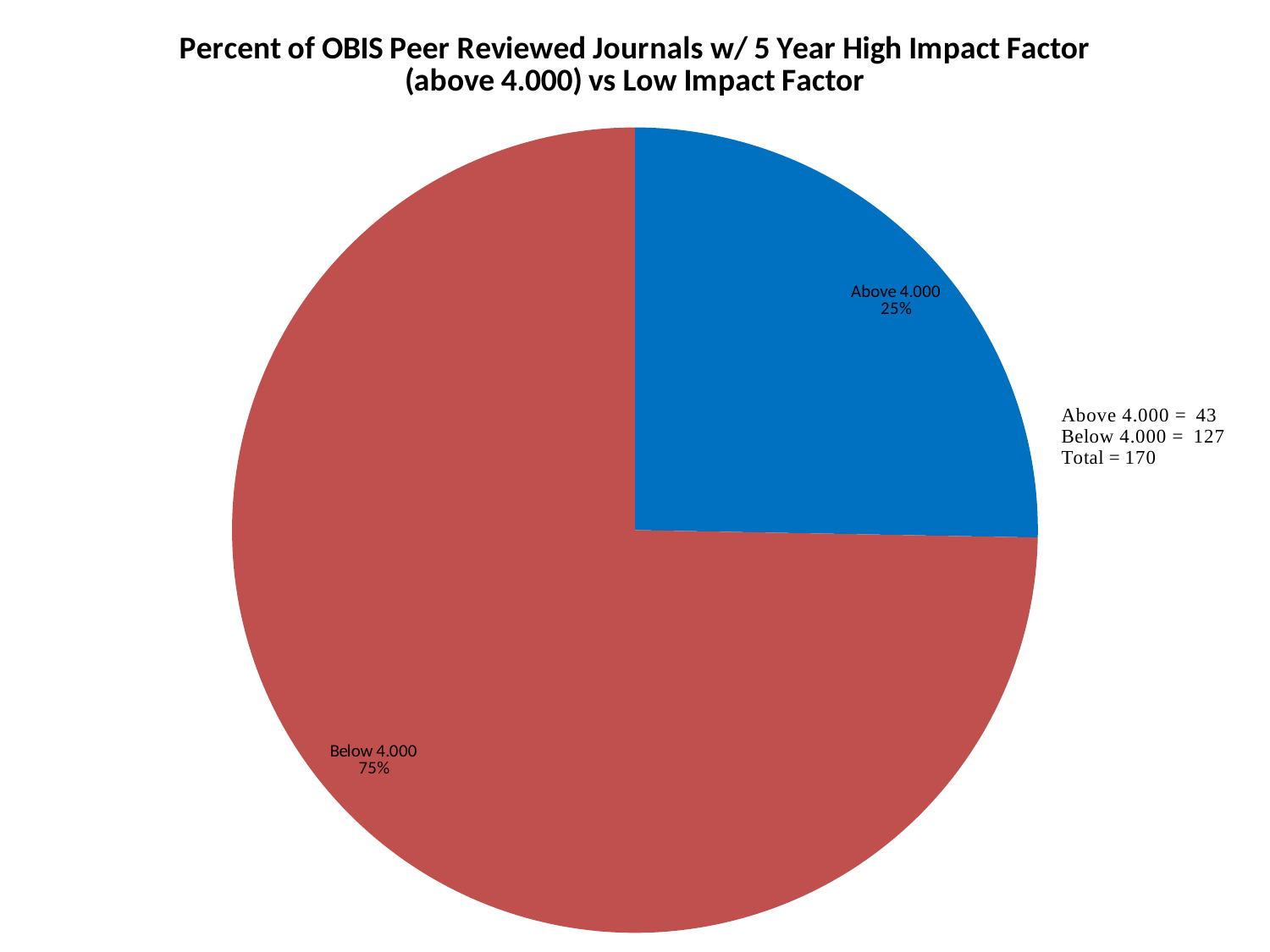
What percentage of the pie is labelled 'Above 4.000'? 25% What is the difference in percentage points between the 'Below 4.000' and 'Above 4.000' slices? 50 What percentage of the pie is labelled 'Below 4.000'? 75% Which slice is larger, 'Above 4.000' or 'Below 4.000'? Below 4.000 What total number of journals is stated beside the chart? 170 Which slice of the pie is the smallest? Above 4.000 How many slices does the pie chart have? 2 Which slice of the pie is the largest? Below 4.000 According to the text beside the chart, how many journals are 'Below 4.000'? 127 According to the text beside the chart, how many journals are 'Above 4.000'? 43 What kind of chart is shown on the slide? pie chart What colour is the 'Above 4.000' slice? blue